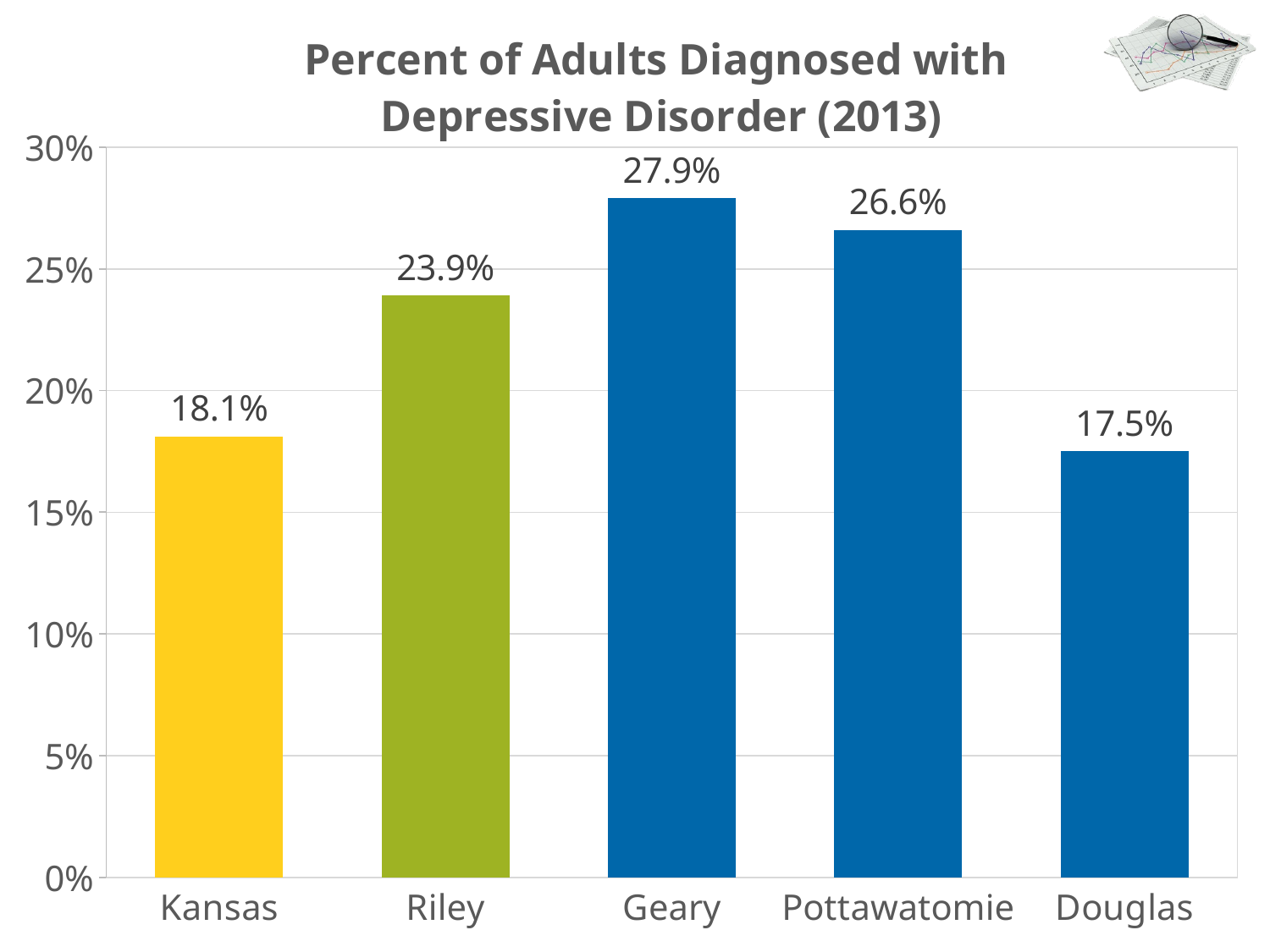
What is the value for Pottawatomie? 26.6% What is the title of the chart? Percent of Adults Diagnosed with Depressive Disorder (2013) What is the value for Riley? 23.9% Which category has the lowest value? Douglas What is the difference between the values for Geary and Douglas? 10.4% Which is larger, the value for Geary or the value for Pottawatomie? Geary What is the value for Kansas? 18.1% Is the value for Riley greater or less than 25%? less What is the difference between the values for Riley and Kansas? 5.8% Which category has the highest value? Geary How many categories are shown on the x axis? 5 What kind of chart is shown on the slide? bar chart